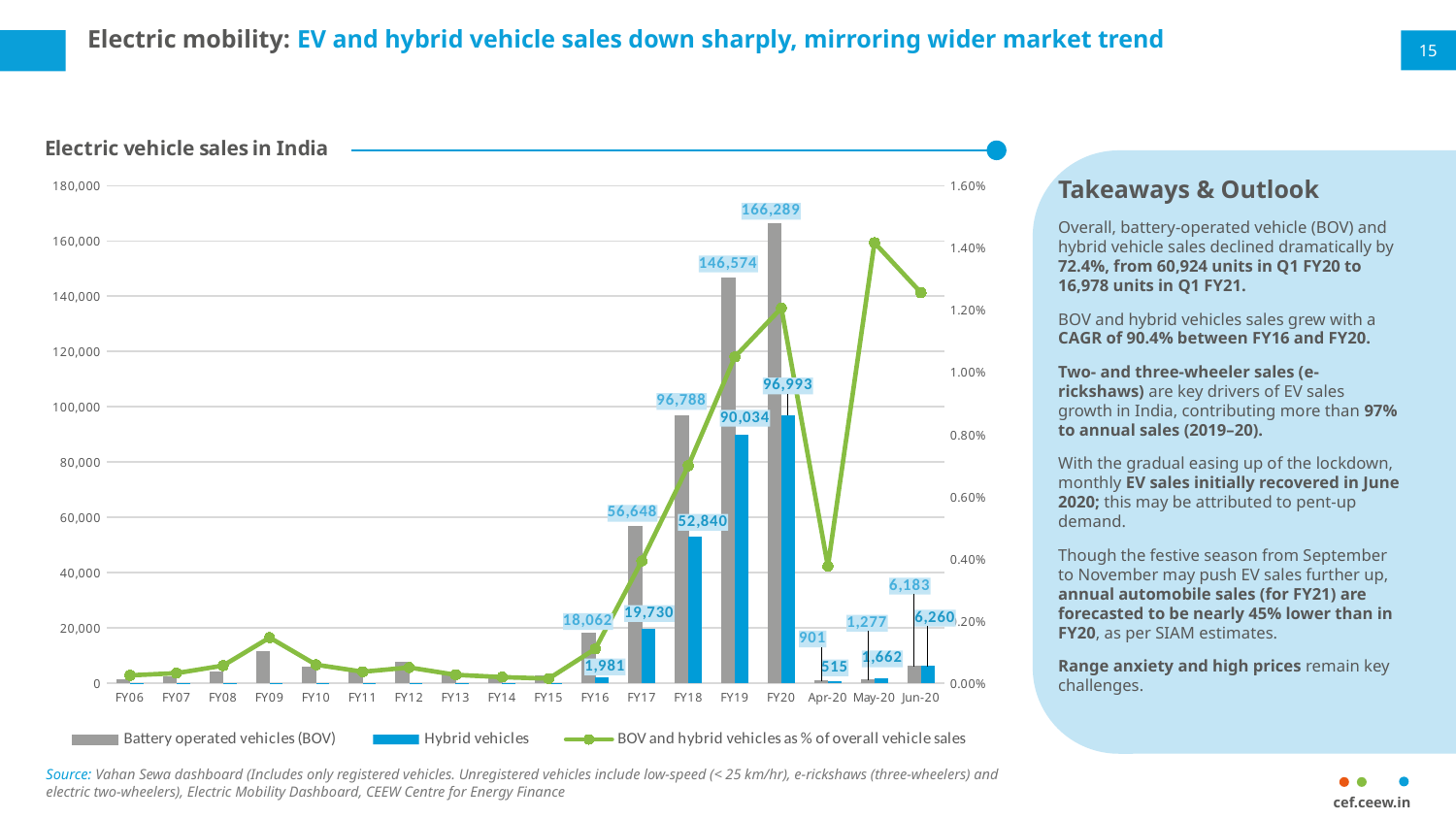
In which period are battery operated vehicle (BOV) sales highest? FY20 Do BOV sales rise or fall from FY16 to FY20? rise What is the value of hybrid vehicle sales in Apr-20? 515 How many periods are shown on the x axis? 18 What is the value of battery operated vehicles (BOV) sales in FY20? 166,289 Is the BOV sales value for FY09 greater or less than 20,000? less How many series does the legend list? 3 What is the value of hybrid vehicle sales in FY19? 90,034 By how much did BOV sales increase from FY19 to FY20? 19,715 Among the labelled hybrid vehicle values, which period has the lowest sales? Apr-20 In Jun-20, which is larger: BOV sales or hybrid vehicle sales? Hybrid vehicles What is the difference between BOV sales and hybrid vehicle sales in FY20? 69,296